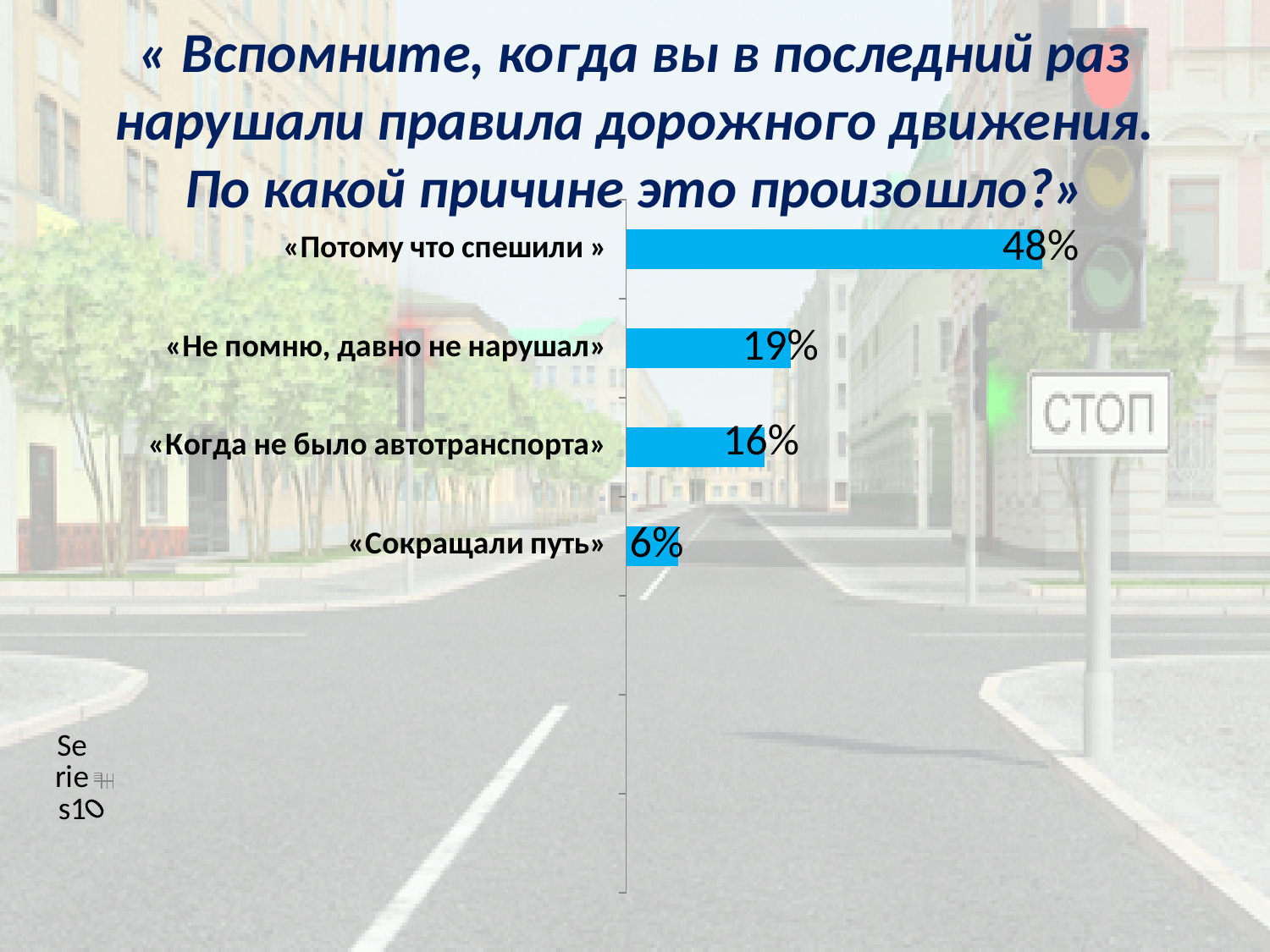
What colour are the bars in the chart? Blue What is the value for «Когда не было автотранспорта»? 16% Which category has the lowest value? «Сокращали путь» What is the value for «Сокращали путь»? 6% Which category has the highest value? «Потому что спешили» What is the difference between the values for «Потому что спешили» and «Не помню, давно не нарушал»? 29% What is the value for «Потому что спешили»? 48% What is the difference between the values for «Когда не было автотранспорта» and «Сокращали путь»? 10% What kind of chart is shown on the slide? Bar chart What is the value for «Не помню, давно не нарушал»? 19% How many categories are shown in the chart? 4 Which is larger: the value for «Не помню, давно не нарушал» or the value for «Когда не было автотранспорта»? «Не помню, давно не нарушал»